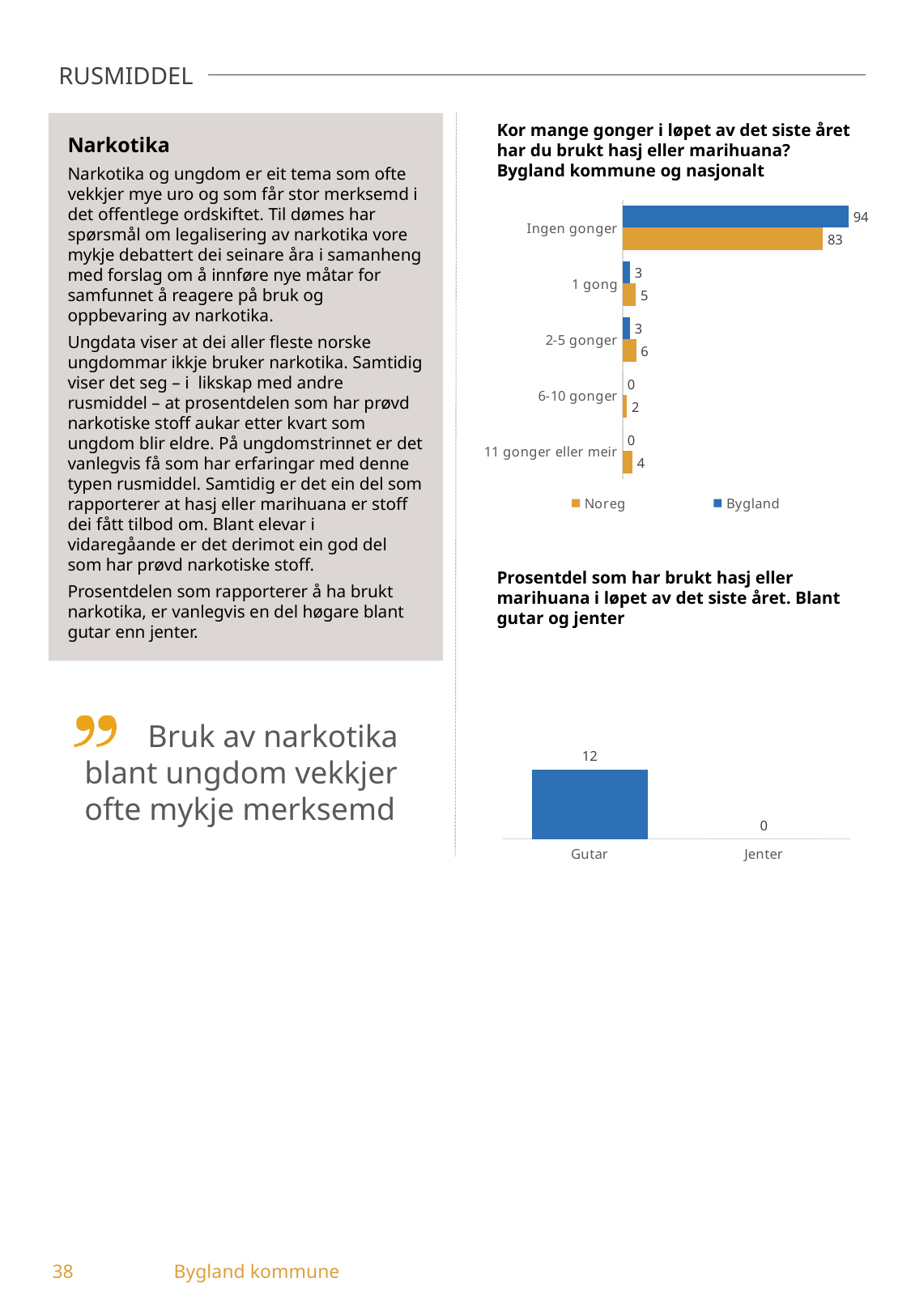
In the top chart (hasj eller marihuana, Bygland kommune og nasjonalt), which is larger for '1 gong': Noreg or Bygland? Noreg In the top chart (hasj eller marihuana, Bygland kommune og nasjonalt), which category has the highest value for Noreg? Ingen gonger In the top chart (hasj eller marihuana, Bygland kommune og nasjonalt), what is the value for Noreg for '2-5 gonger'? 6 In the top chart (hasj eller marihuana, Bygland kommune og nasjonalt), how many categories are shown? 5 In the top chart (hasj eller marihuana, Bygland kommune og nasjonalt), what is the value for Noreg for '11 gonger eller meir'? 4 In the bottom chart (Prosentdel som har brukt hasj eller marihuana, gutar og jenter), what is the difference between Gutar and Jenter? 12 In the bottom chart (Prosentdel som har brukt hasj eller marihuana, gutar og jenter), what is the value for Gutar? 12 In the top chart (hasj eller marihuana, Bygland kommune og nasjonalt), how many series does the legend list? 2 What kind of chart is the top chart (hasj eller marihuana, Bygland kommune og nasjonalt)? Bar chart In the top chart (hasj eller marihuana, Bygland kommune og nasjonalt), what is the value for Bygland for 'Ingen gonger'? 94 In the bottom chart (Prosentdel som har brukt hasj eller marihuana, gutar og jenter), what is the value for Jenter? 0 In the top chart (hasj eller marihuana, Bygland kommune og nasjonalt), what is the difference between Bygland and Noreg for 'Ingen gonger'? 11